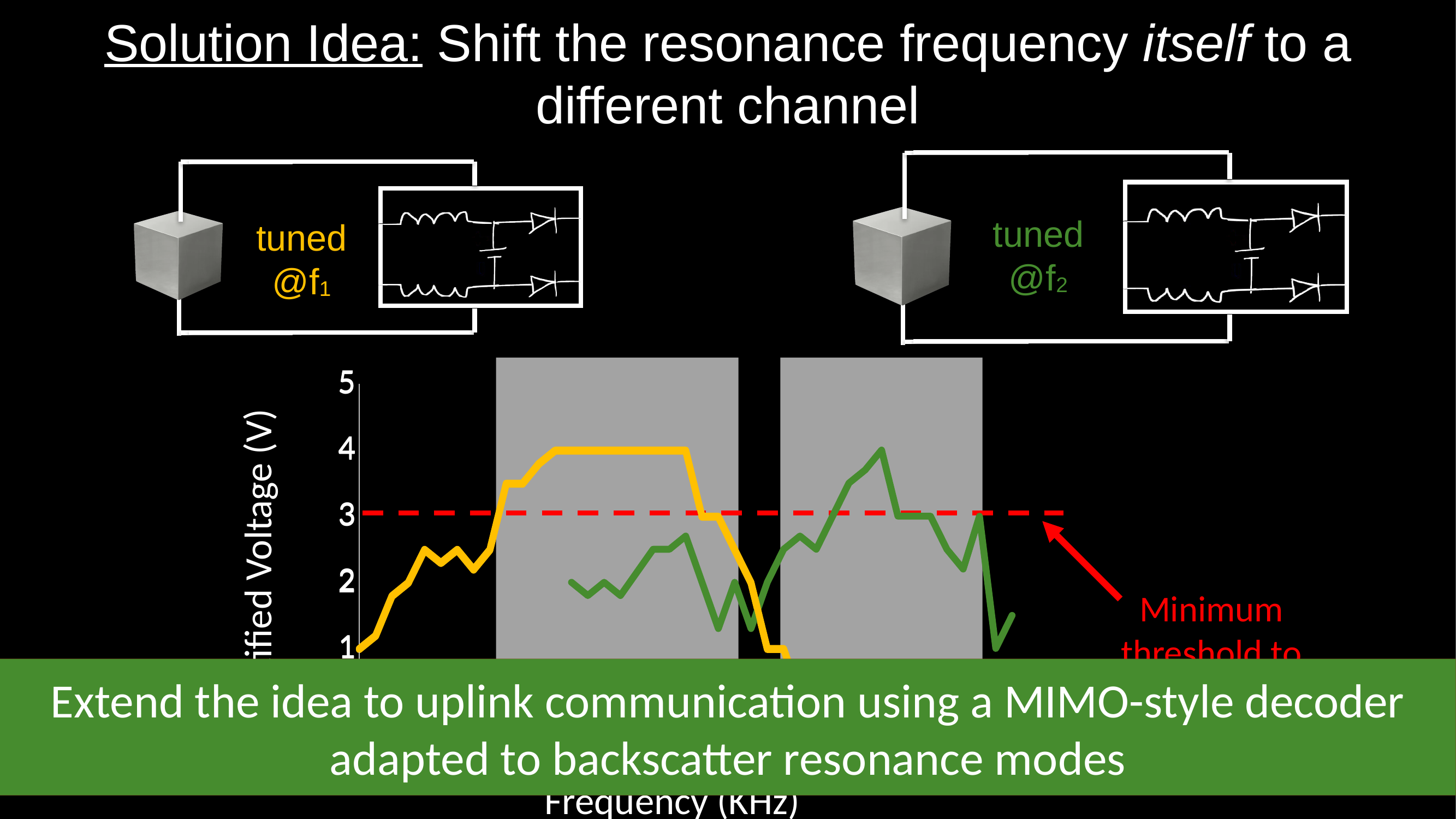
How many data lines are plotted on the chart? 2 Is the peak value of the green line greater or less than 3? greater What kind of chart is shown on the slide? line chart Does the yellow line rise or fall from the left edge of the chart up to the first shaded region? rise What is the highest value shown on the y axis of the chart? 5 Is the lowest value of the green line greater or less than 2? less At what voltage is the red dashed threshold line drawn on the chart? 3 Does the yellow line rise or fall after it leaves the first shaded region? fall Is the peak value of the yellow line greater or less than 3? greater How many grey shaded regions are drawn on the chart? 2 What is the label of the x axis of the chart? Frequency (kHz)